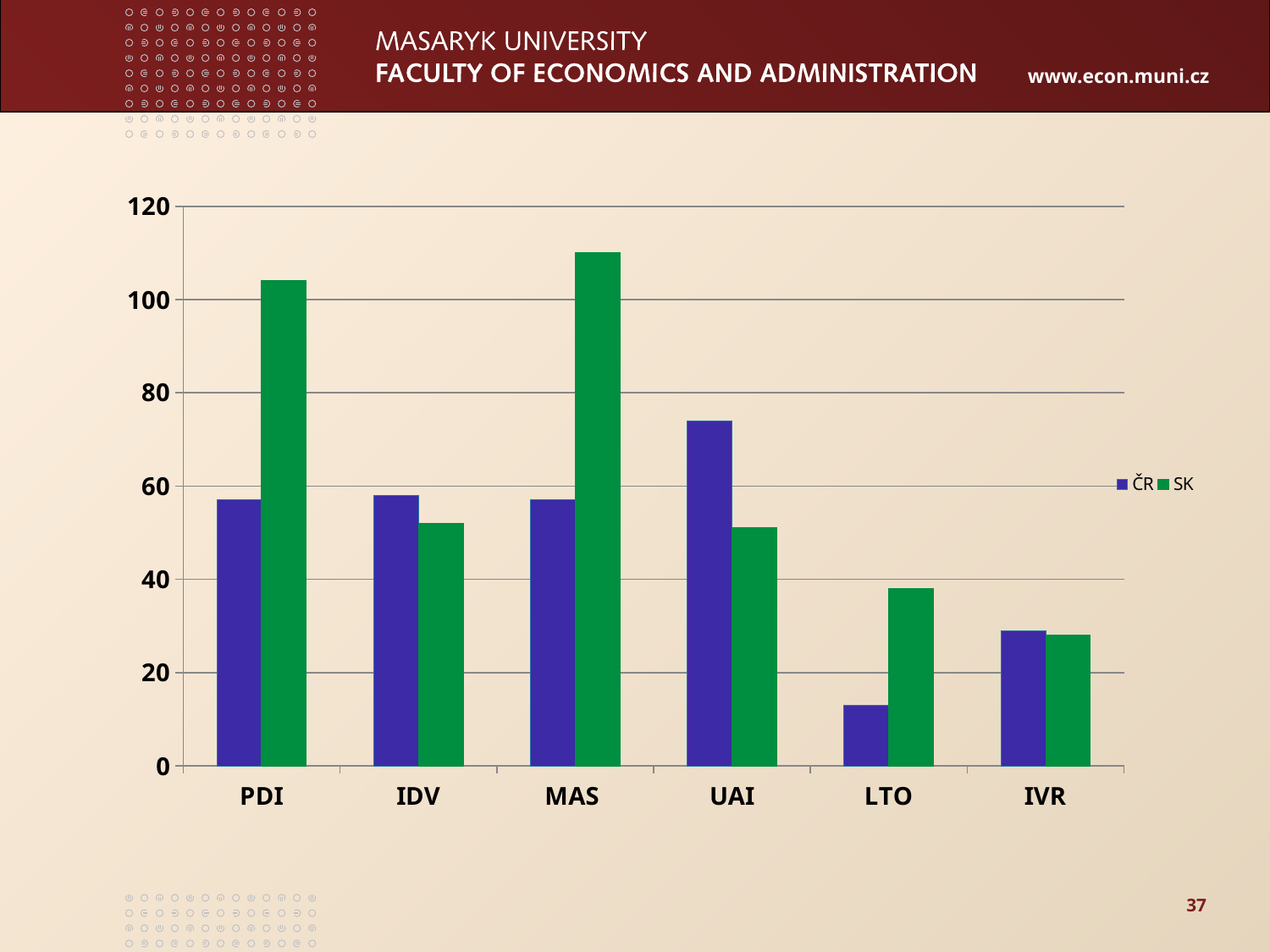
Which colour represents the SK series in the legend? green How many series does the legend list? 2 Which category has the lowest value for the SK series? IVR For UAI, which series has the larger value, ČR or SK? ČR What kind of chart is shown on the slide? bar chart How many categories are shown on the x axis? 6 Is the SK value for MAS greater or less than 100? greater Which category has the highest value for the SK series? MAS Which category has the highest value for the ČR series? UAI For PDI, which series has the larger value, ČR or SK? SK Which category has the lowest value for the ČR series? LTO Is the ČR value for LTO greater or less than 20? less